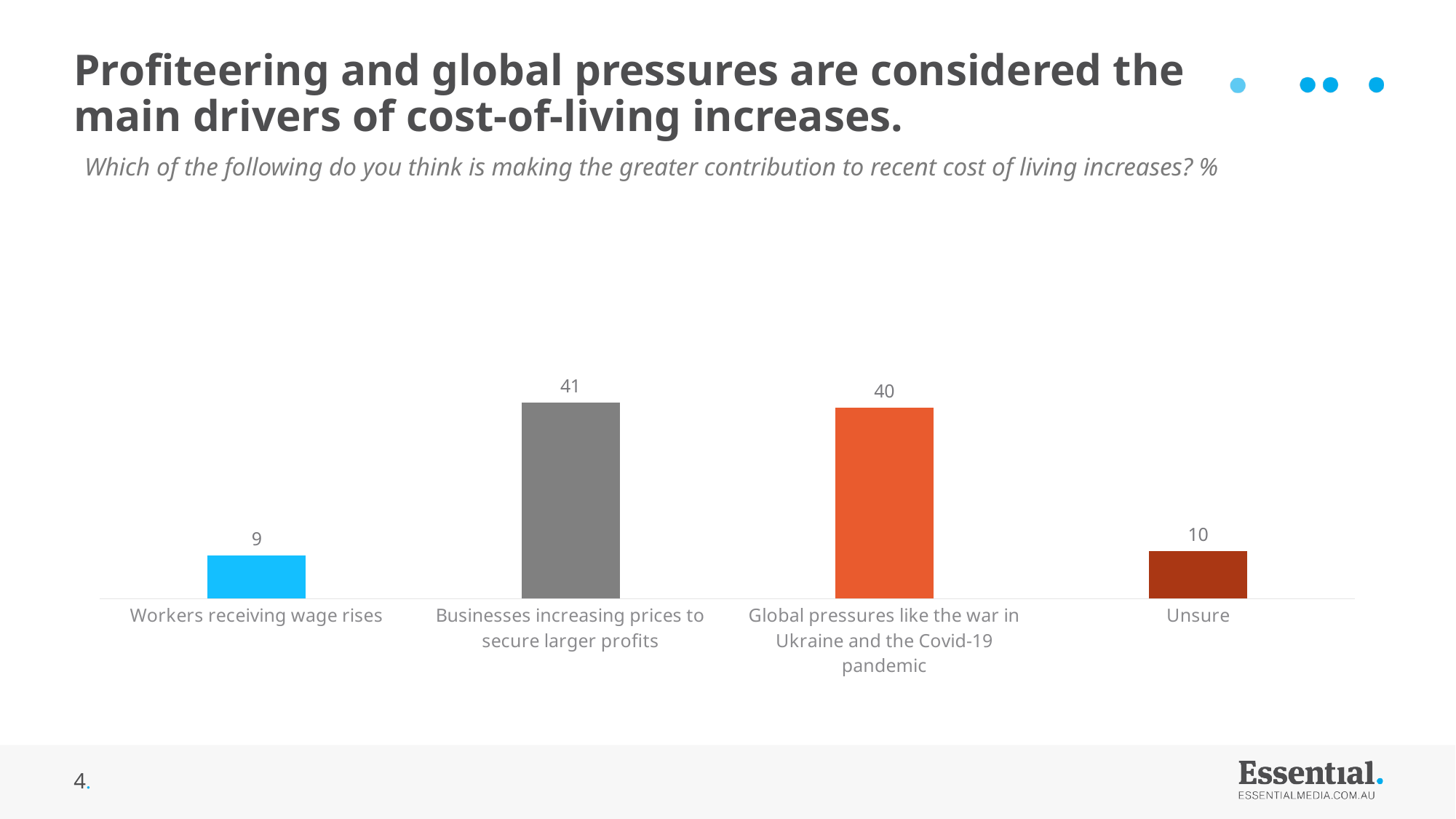
Which category has the lowest value? Workers receiving wage rises What is the difference between the values for "Businesses increasing prices to secure larger profits" and "Workers receiving wage rises"? 32 What kind of chart is shown on the slide? Bar chart What is the value for "Global pressures like the war in Ukraine and the Covid-19 pandemic"? 40 What is the value for "Unsure"? 10 Which category has the highest value? Businesses increasing prices to secure larger profits What is the difference between the values for "Global pressures like the war in Ukraine and the Covid-19 pandemic" and "Unsure"? 30 What is the value for "Workers receiving wage rises"? 9 What colour is the bar for "Global pressures like the war in Ukraine and the Covid-19 pandemic"? Orange How many categories are shown in the chart? 4 What is the value for "Businesses increasing prices to secure larger profits"? 41 Which is larger: the value for "Unsure" or the value for "Workers receiving wage rises"? Unsure